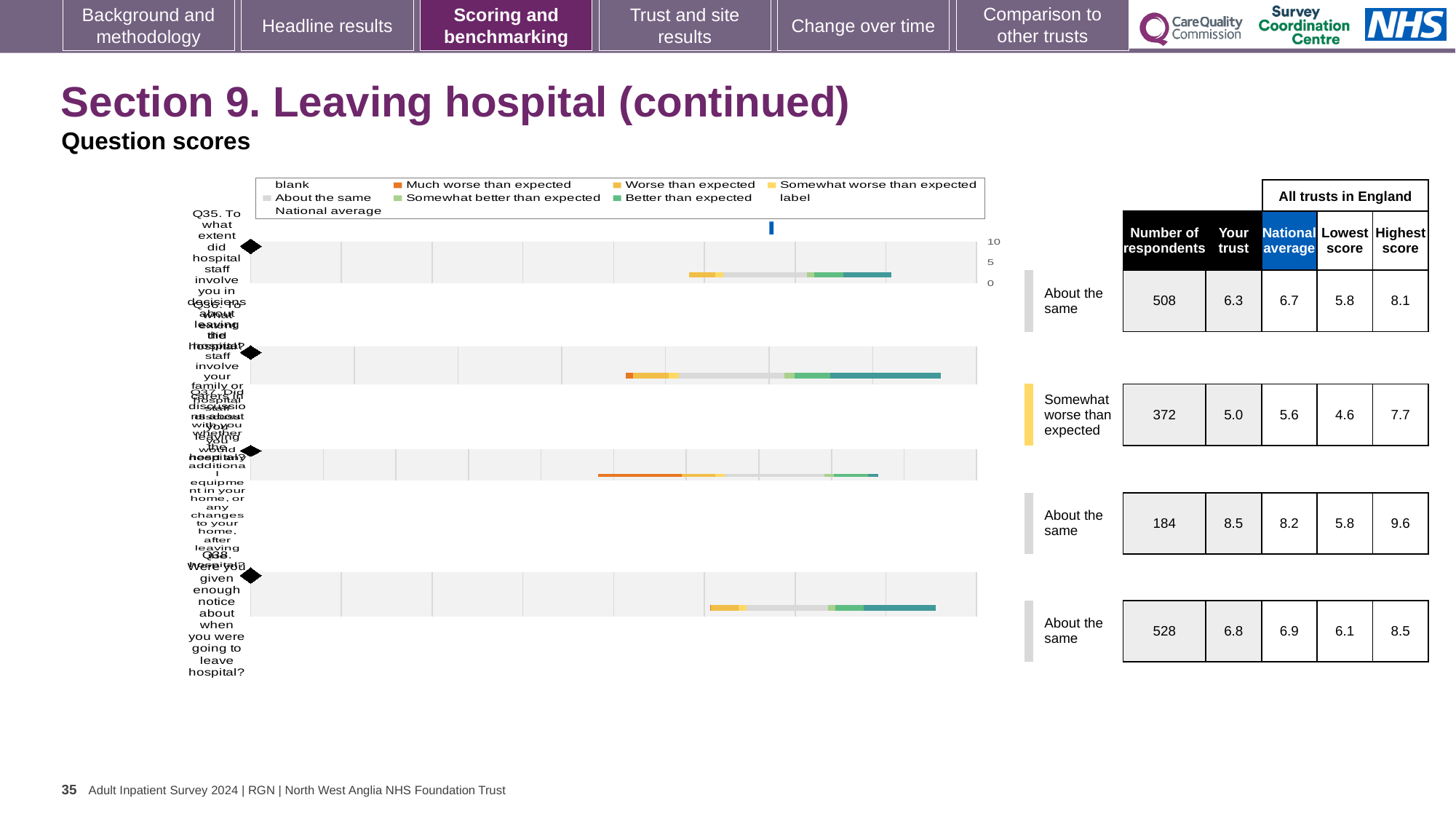
How many questions (bars) are plotted in the chart? 4 What is the national average score for Q36? 5.6 What is the highest score across all trusts in England for Q38? 8.5 Which question is rated 'Somewhat worse than expected'? Q36 What kind of chart is shown on the slide? Bar chart Which question has the highest 'Your trust' score? Q37 For Q35, which is larger: the 'Your trust' score or the national average? National average How many respondents are listed for Q37? 184 What is the 'Your trust' score for Q35? 6.3 For Q37, how much higher is the 'Your trust' score than the national average? 0.3 What colour does the legend use for 'Much worse than expected'? Orange Which question has the lowest 'Your trust' score? Q36